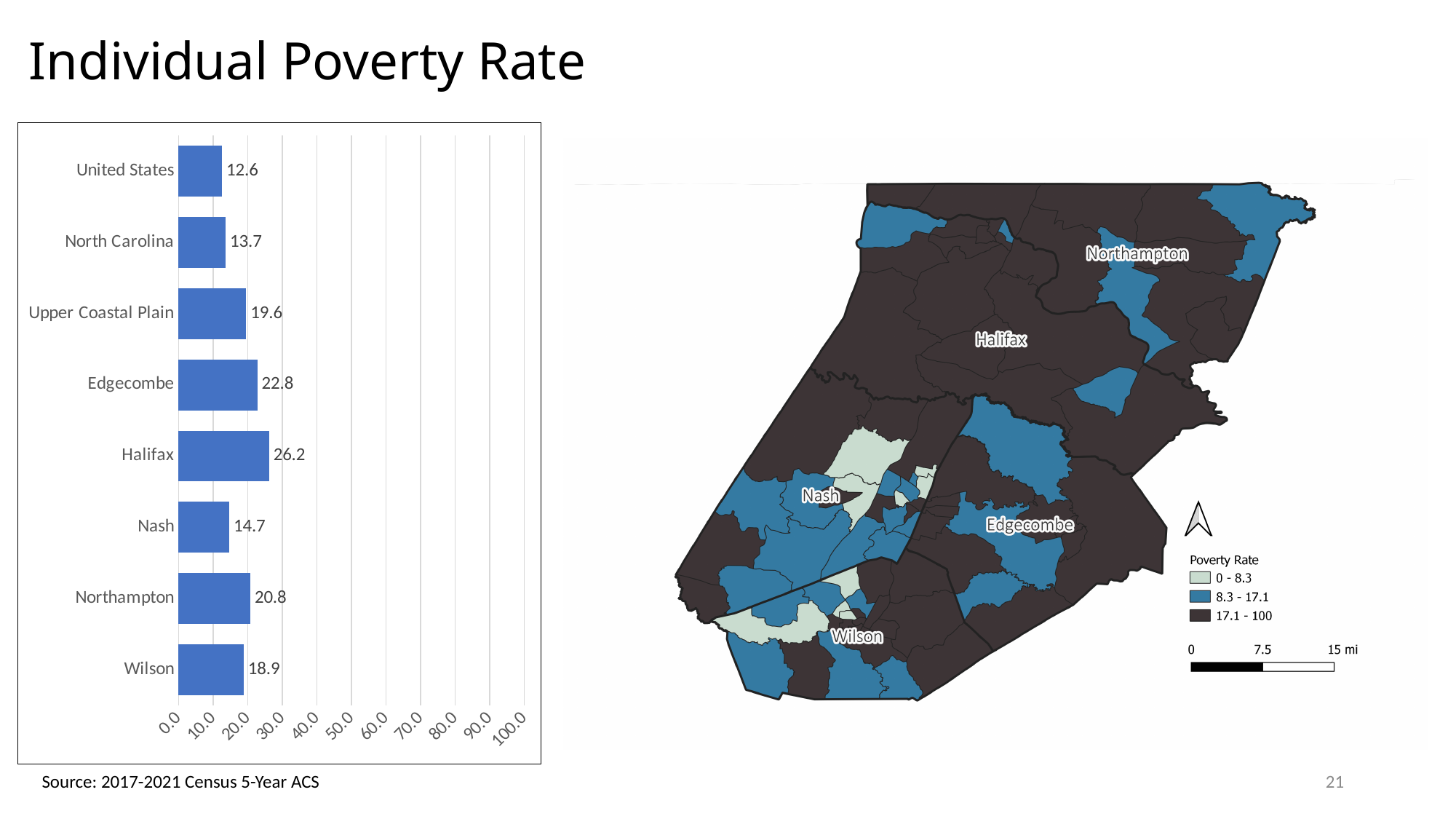
Which has a higher individual poverty rate in the bar chart, Northampton or Wilson? Northampton What is the individual poverty rate for Wilson in the bar chart? 18.9 Which category has the highest individual poverty rate in the bar chart? Halifax How many categories are shown in the bar chart? 8 What is the highest value shown on the x axis of the bar chart? 100.0 What kind of chart is shown on the left of the slide? Bar chart What is the individual poverty rate for Halifax in the bar chart? 26.2 Which category has the lowest individual poverty rate in the bar chart? United States What is the difference between the poverty rates of Upper Coastal Plain and North Carolina in the bar chart? 5.9 What is the individual poverty rate for the United States in the bar chart? 12.6 Is the value for Halifax in the bar chart greater or less than 20.0? greater What is the difference between the poverty rates of Edgecombe and Nash in the bar chart? 8.1